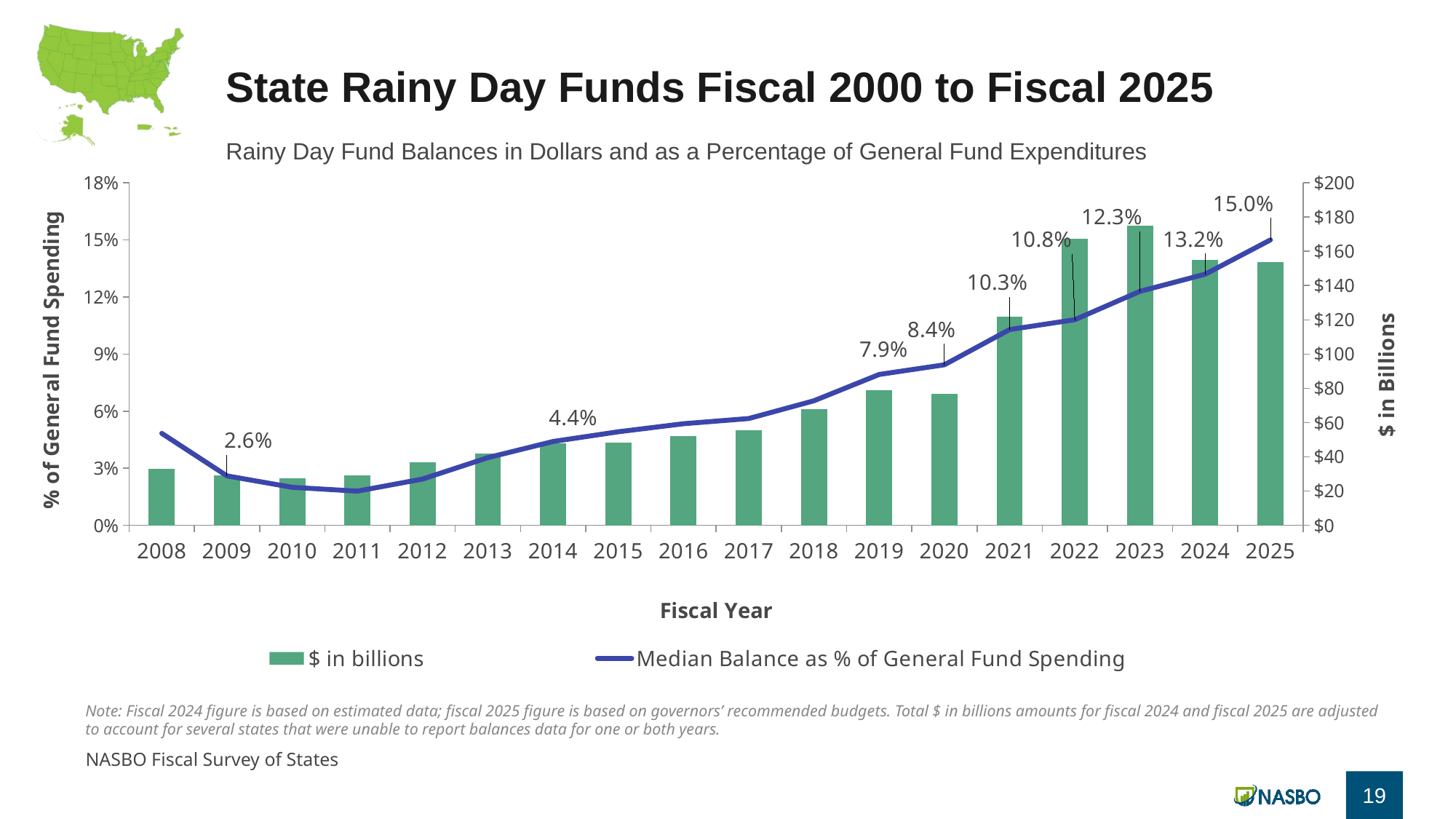
How many series does the legend list? 2 What is the median balance as a percentage of general fund spending in fiscal 2021? 10.3% By how many percentage points did the median balance as a percentage of general fund spending rise from fiscal 2024 to fiscal 2025? 1.8 percentage points What is the median balance as a percentage of general fund spending in fiscal 2025? 15.0% Is the $ in billions bar for fiscal 2023 greater or less than $160? greater Which is larger, the $ in billions bar for fiscal 2023 or for fiscal 2025? 2023 What is the median balance as a percentage of general fund spending in fiscal 2009? 2.6% Which fiscal year has the tallest bar for $ in billions? 2023 How many fiscal years are shown on the x axis? 18 Is the $ in billions bar for fiscal 2008 greater or less than $40? less Does the median balance as a percentage of general fund spending rise or fall from fiscal 2011 to fiscal 2025? rise What is the difference between the median balance percentages for fiscal 2023 and fiscal 2022? 1.5 percentage points